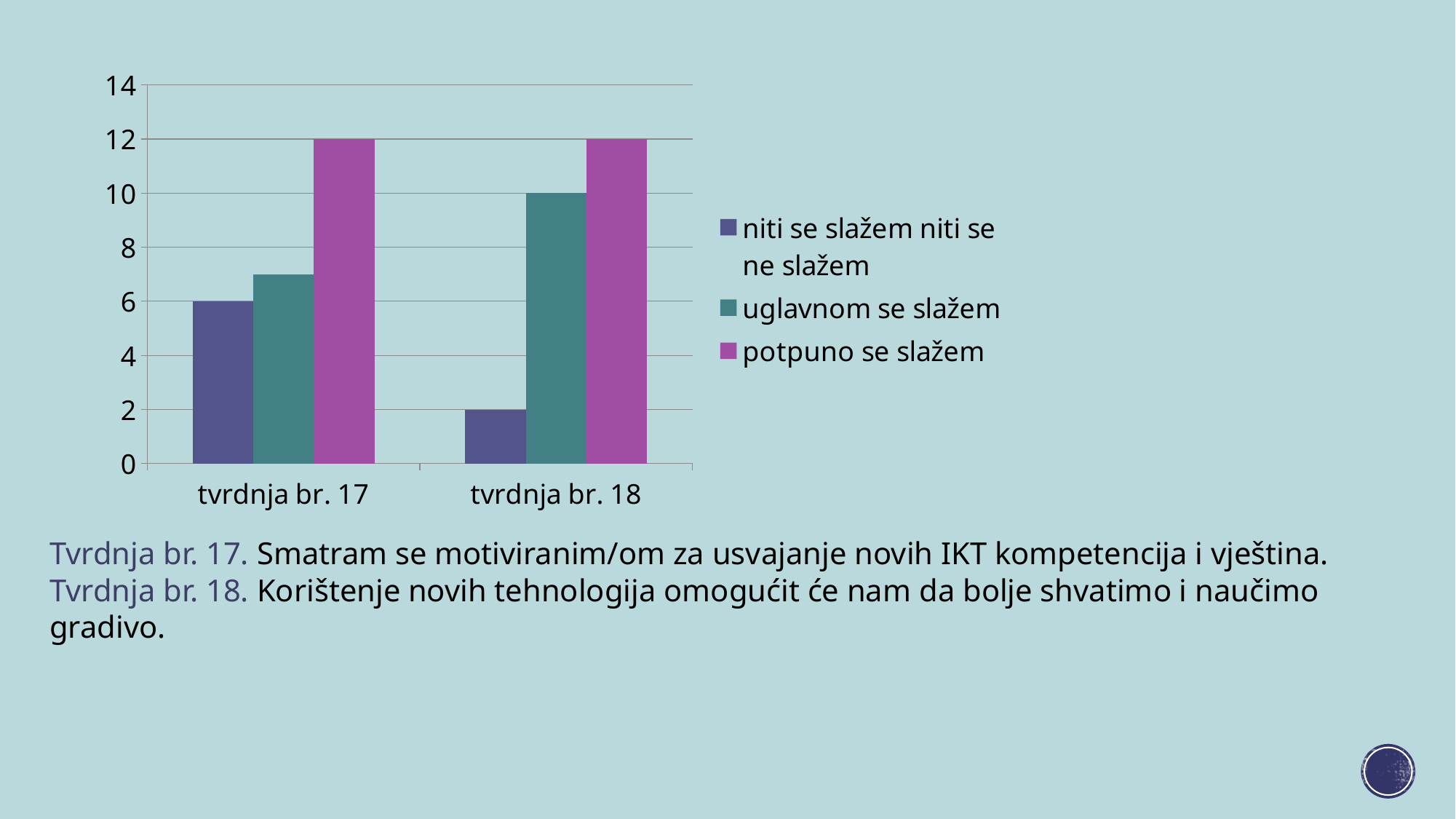
What is the value for "niti se slažem niti se ne slažem" for tvrdnja br. 18? 2 What is the value for "potpuno se slažem" for tvrdnja br. 17? 12 What is the value for "niti se slažem niti se ne slažem" for tvrdnja br. 17? 6 What is the value for "uglavnom se slažem" for tvrdnja br. 18? 10 What is the difference between the "uglavnom se slažem" value for tvrdnja br. 18 and the "niti se slažem niti se ne slažem" value for tvrdnja br. 18? 8 Is the value for "uglavnom se slažem" for tvrdnja br. 17 greater or less than 8? less What kind of chart is shown on the slide? bar chart How many series does the legend list? 3 Which series has the highest value for tvrdnja br. 17? potpuno se slažem Which series has the lowest value for tvrdnja br. 18? niti se slažem niti se ne slažem Which is larger: the "niti se slažem niti se ne slažem" value for tvrdnja br. 17 or for tvrdnja br. 18? tvrdnja br. 17 What is the value for "potpuno se slažem" for tvrdnja br. 18? 12